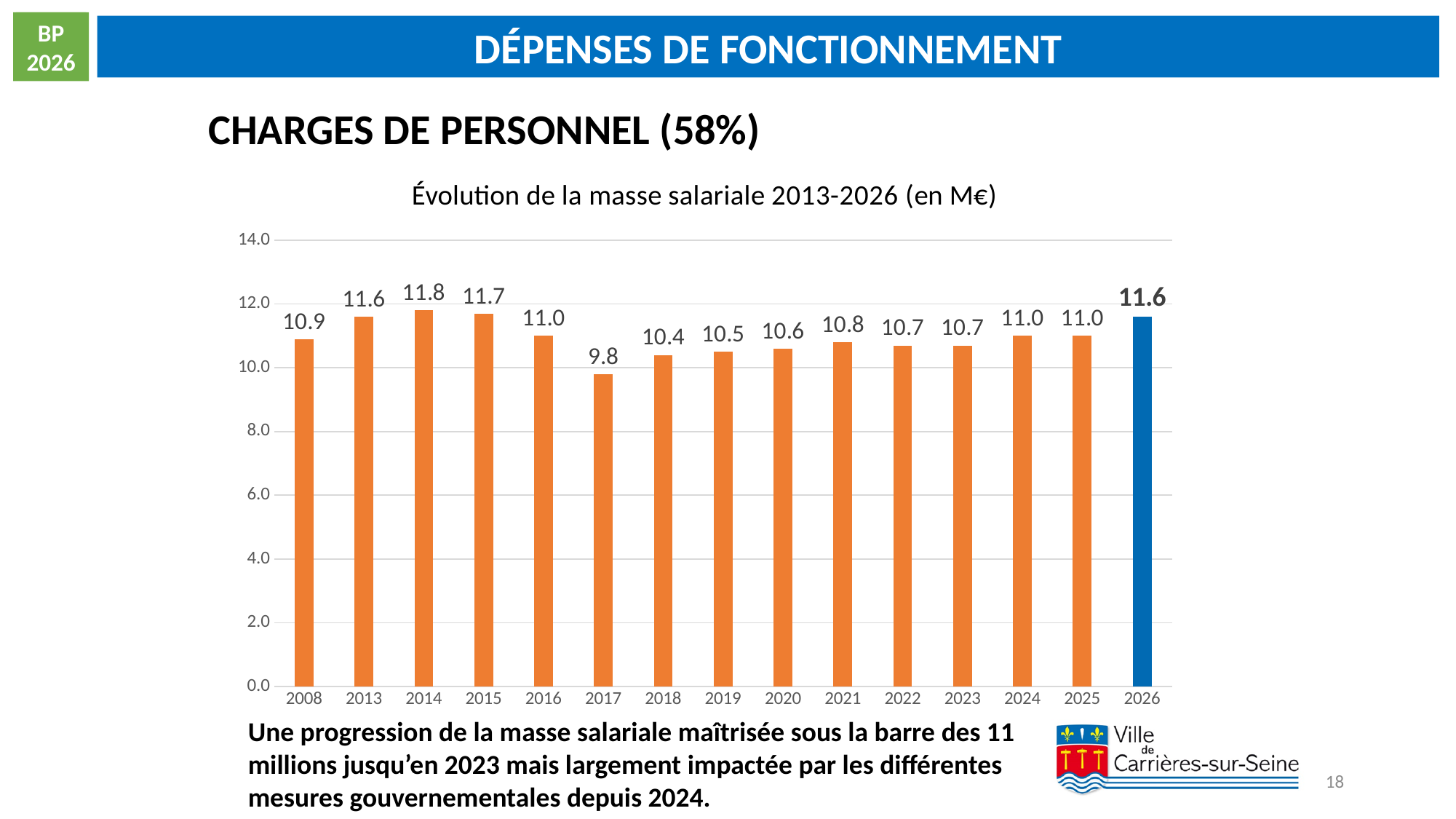
What is the value for 2026 in the chart? 11.6 Do the values rise or fall from 2017 to 2026? rise What is the difference between the values for 2014 and 2017? 2.0 How many years are shown on the x axis of the chart? 15 What is the difference between the values for 2026 and 2025? 0.6 What is the title of the chart? Évolution de la masse salariale 2013-2026 (en M€) What kind of chart is shown on the slide? bar chart Which year has the highest value in the chart? 2014 What is the value for 2017 in the chart? 9.8 Which is larger, the value for 2015 or the value for 2021? 2015 Which year has the lowest value in the chart? 2017 What is the value for 2008 in the chart? 10.9